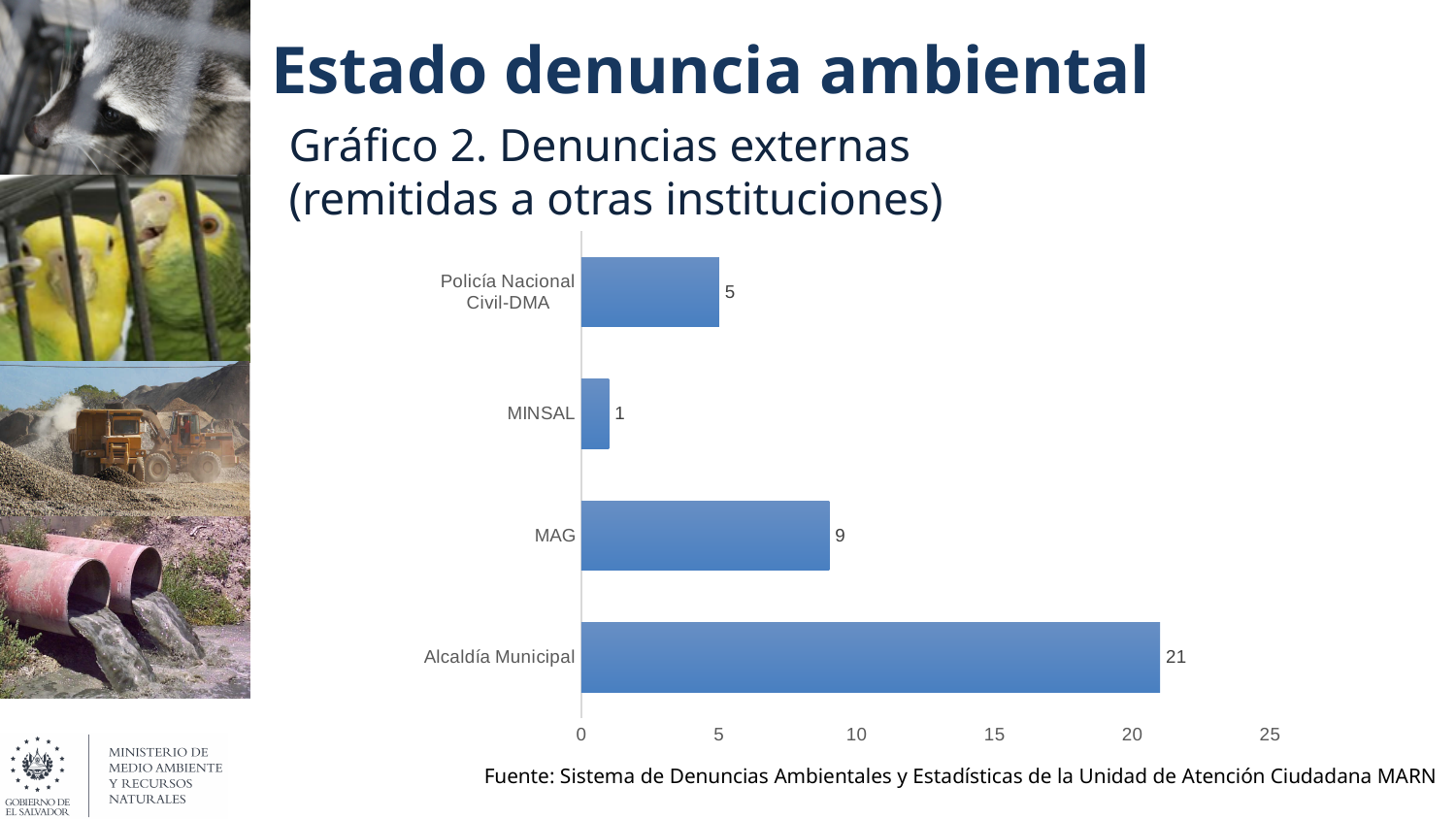
How many categories are shown in the chart? 4 Which category has the highest value? Alcaldía Municipal What is the value for MINSAL? 1 Which category has the lowest value? MINSAL What is the value for Alcaldía Municipal? 21 What kind of chart is shown on the slide? bar chart Is the value for Alcaldía Municipal greater or less than 20? greater What is the value for Policía Nacional Civil-DMA? 5 What is the title of the chart? Gráfico 2. Denuncias externas (remitidas a otras instituciones) Which is larger, the value for MAG or the value for Policía Nacional Civil-DMA? MAG What is the difference between the values for Alcaldía Municipal and MAG? 12 What is the value for MAG? 9